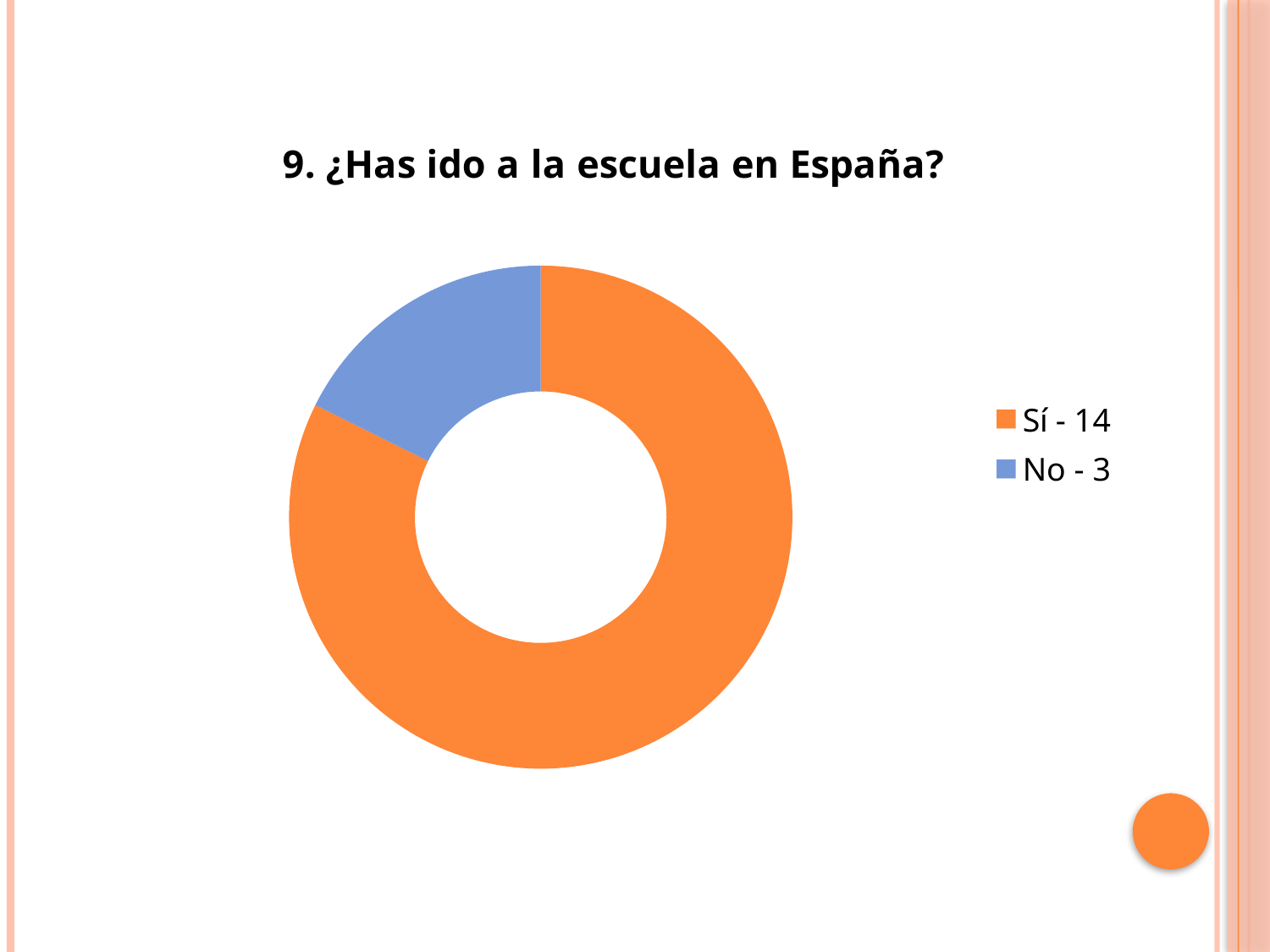
What is the value for No? 3 Which colour represents the No category? Blue Which category has the smallest value? No Which is larger, the value for Sí or the value for No? Sí What is the total of all the values in the chart? 17 How many categories does the legend list? 2 What is the title of the chart? 9. ¿Has ido a la escuela en España? What is the value for Sí? 14 What is the difference between the values for Sí and No? 11 What kind of chart is shown on the slide? Doughnut (pie) chart Which category has the largest value? Sí